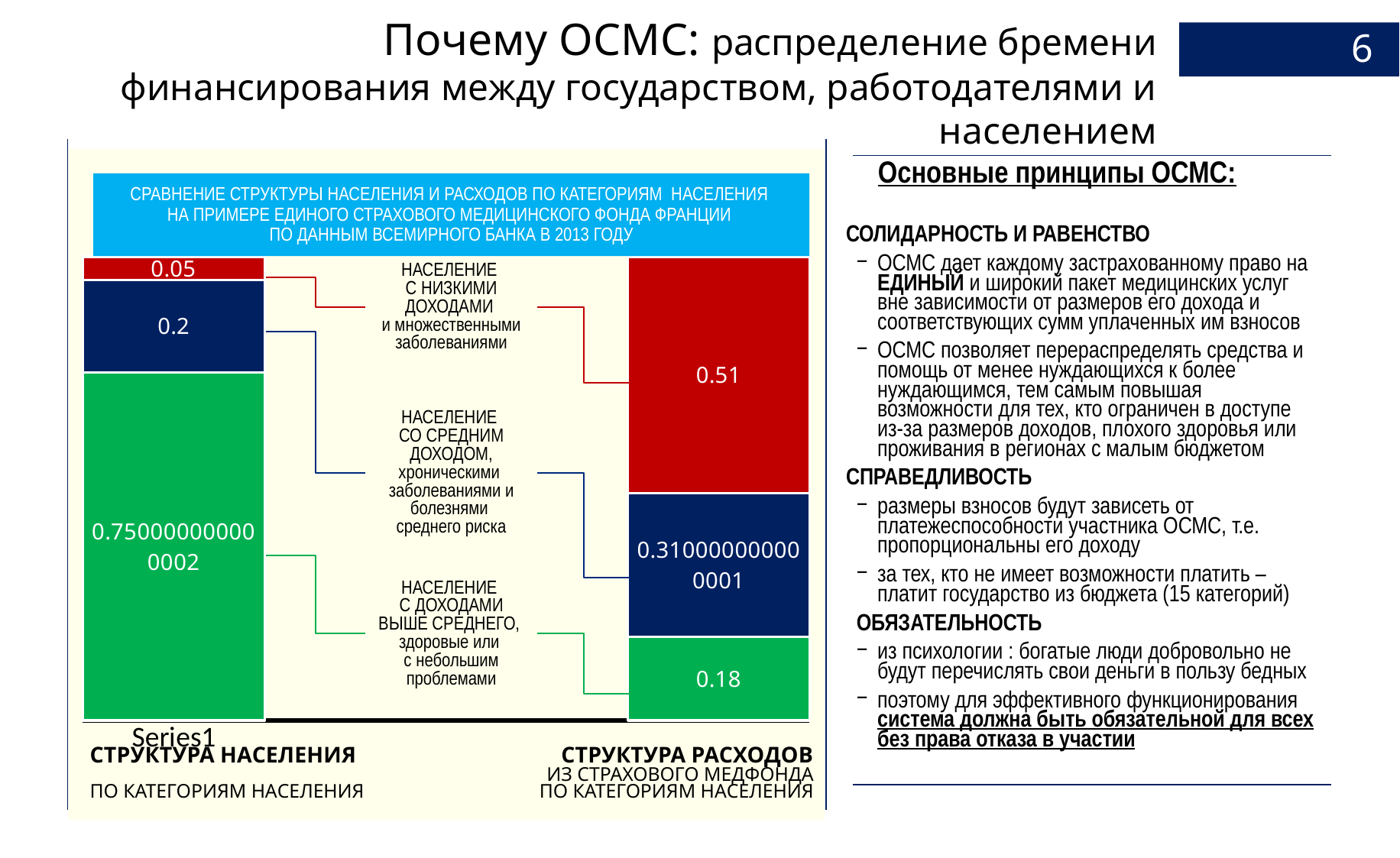
For the low-income population, which is larger: its share in the population structure or its share in the expenditure structure? expenditure structure (0.51) What is the difference between the low-income segment in the expenditure bar (0.51) and in the population bar (0.05)? 0.46 Which population category has the largest segment in the СТРУКТУРА РАСХОДОВ bar? Население с низкими доходами (0.51) In the СТРУКТУРА РАСХОДОВ bar, what value is shown for the above-average-income population segment (green)? 0.18 In the СТРУКТУРА НАСЕЛЕНИЯ bar, what value is shown for the middle-income population segment (dark blue)? 0.2 In the СТРУКТУРА РАСХОДОВ bar, what value is shown for the low-income population segment (red)? 0.51 How many stacked bars are shown in the chart? 2 In the СТРУКТУРА НАСЕЛЕНИЯ bar, what value is shown for the above-average-income population segment (green)? 0.750000000000002 Which population category has the smallest segment in the СТРУКТУРА НАСЕЛЕНИЯ bar? Население с низкими доходами (0.05) What colour is used for the low-income population segment in the chart? red What kind of chart is shown on the slide? stacked bar chart In the СТРУКТУРА НАСЕЛЕНИЯ bar, what value is shown for the low-income population segment (red)? 0.05